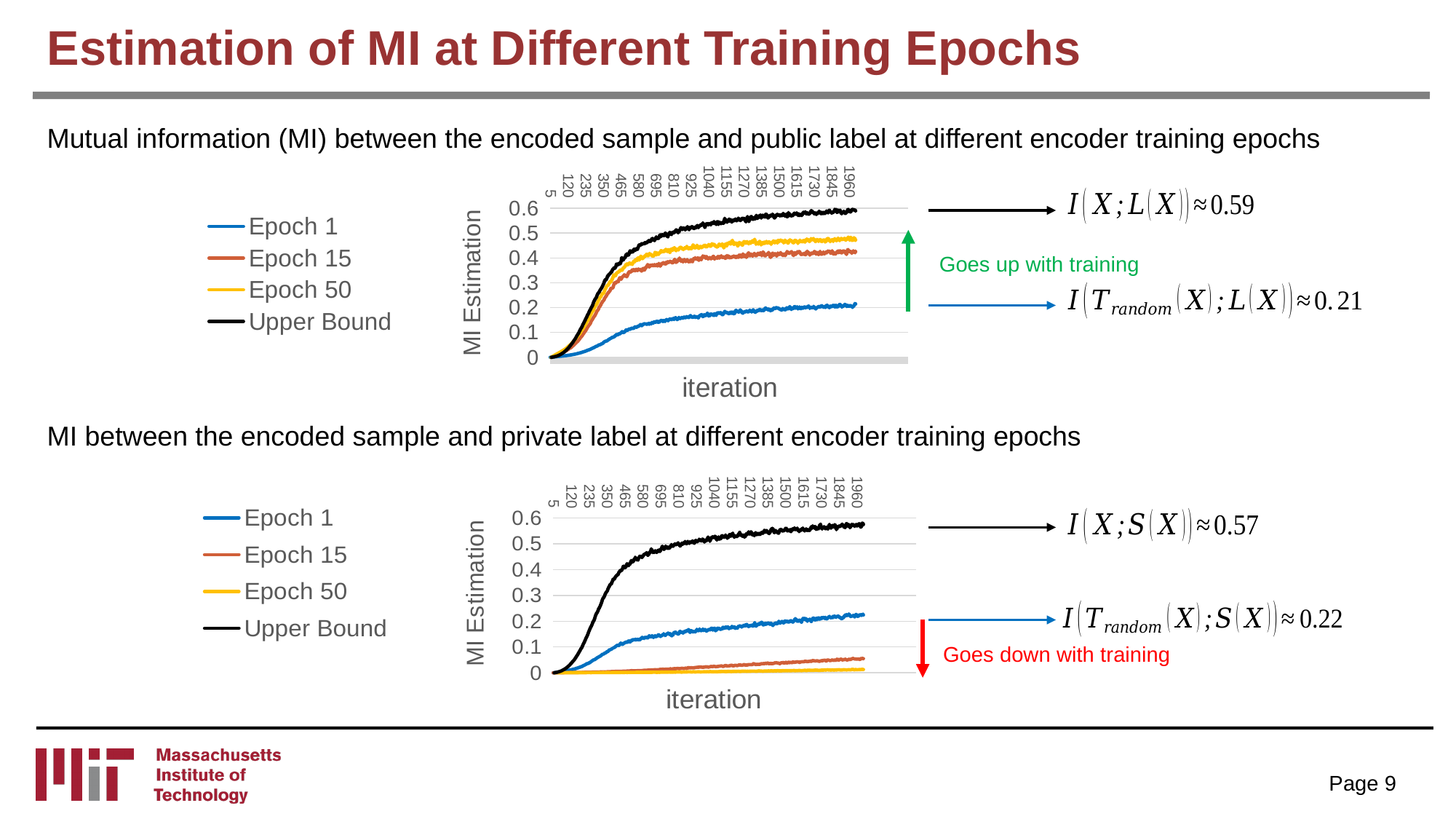
In the top chart (public label), is the Epoch 1 value at the final iteration greater or less than 0.3? less In the bottom chart (private label), which series is higher at the final iteration, Epoch 1 or Epoch 15? Epoch 1 In the top chart (public label), which series has the lowest MI estimation at the final iterations? Epoch 1 In the bottom chart (private label), which series has the lowest MI estimation at the final iterations? Epoch 50 What is the y-axis title of the bottom chart (private label)? MI Estimation In the bottom chart (private label), is the Epoch 15 value at the final iteration greater or less than 0.1? less In the top chart (public label), which series reaches the highest MI estimation? Upper Bound In the top chart (public label), is the Upper Bound value at the final iteration greater or less than 0.5? greater In the top chart (public label), which series is higher at the final iteration, Epoch 50 or Epoch 15? Epoch 50 In the bottom chart (private label), does the Upper Bound series rise or fall as the iteration increases? rises What kind of chart is the top chart (MI with the public label)? line chart How many series does the legend of the top chart list? 4